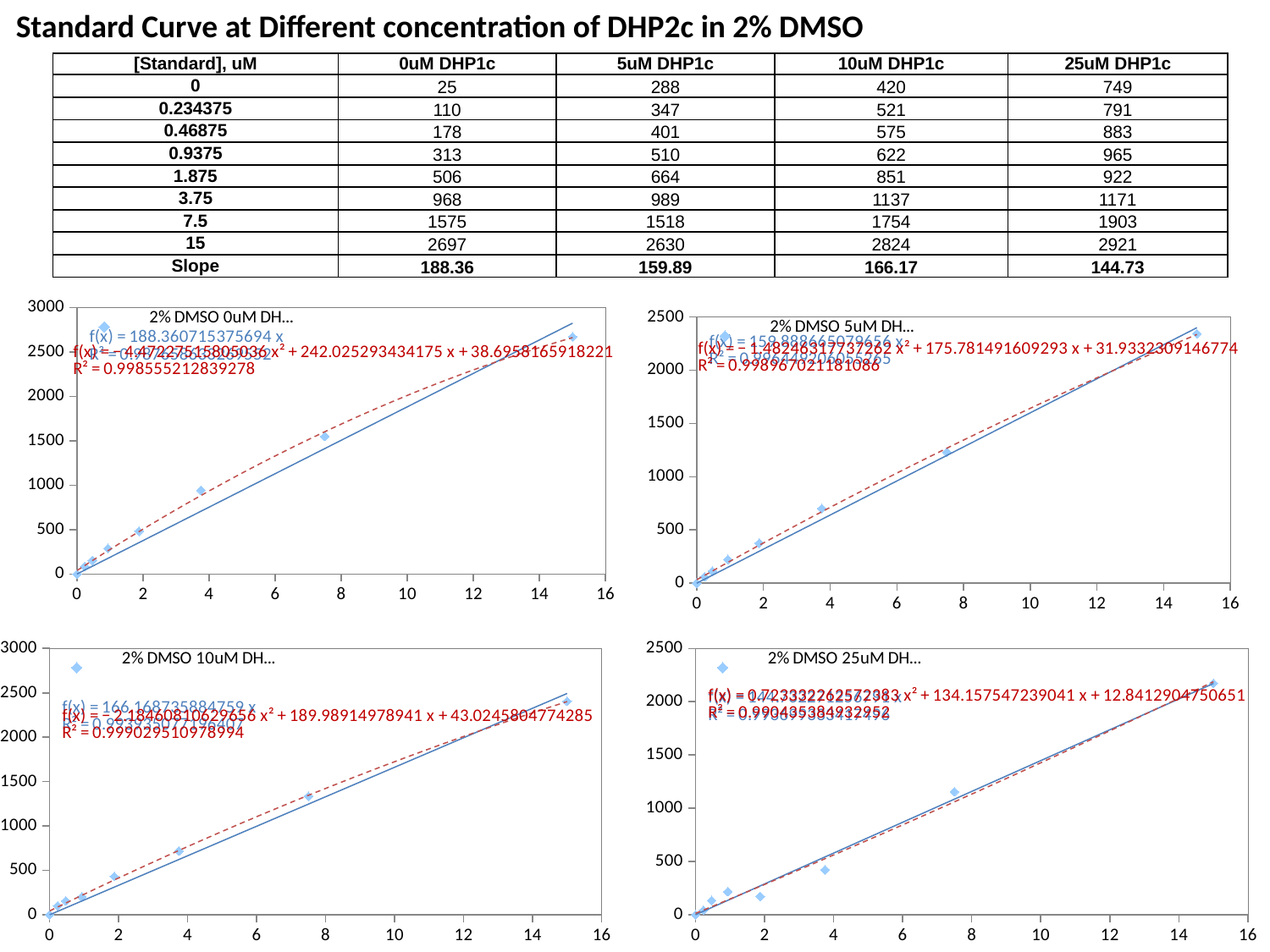
In the top-right chart (2% DMSO 5uM DH...), is the value of the point at x = 15 greater or less than 2000? greater In the bottom-left chart (2% DMSO 10uM DH...), which point has the highest value: the one at x = 7.5 or the one at x = 15? x = 15 In the bottom-right chart (2% DMSO 25uM DH...), is the value of the point at x = 15 greater or less than 2000? greater What kind of chart is the top-left chart titled '2% DMSO 0uM DH...'? scatter chart In the top-left chart (2% DMSO 0uM DH...), do the plotted values rise or fall as the x value increases? rise In the top-left chart (2% DMSO 0uM DH...), is the value of the point at x = 15 greater or less than 2500? greater What is the maximum value shown on the x axis of the bottom-right chart (2% DMSO 25uM DH...)? 16 What is the maximum value shown on the y axis of the top-left chart (2% DMSO 0uM DH...)? 3000 In the bottom-right chart (2% DMSO 25uM DH...), do the plotted values rise or fall along the x axis? rise